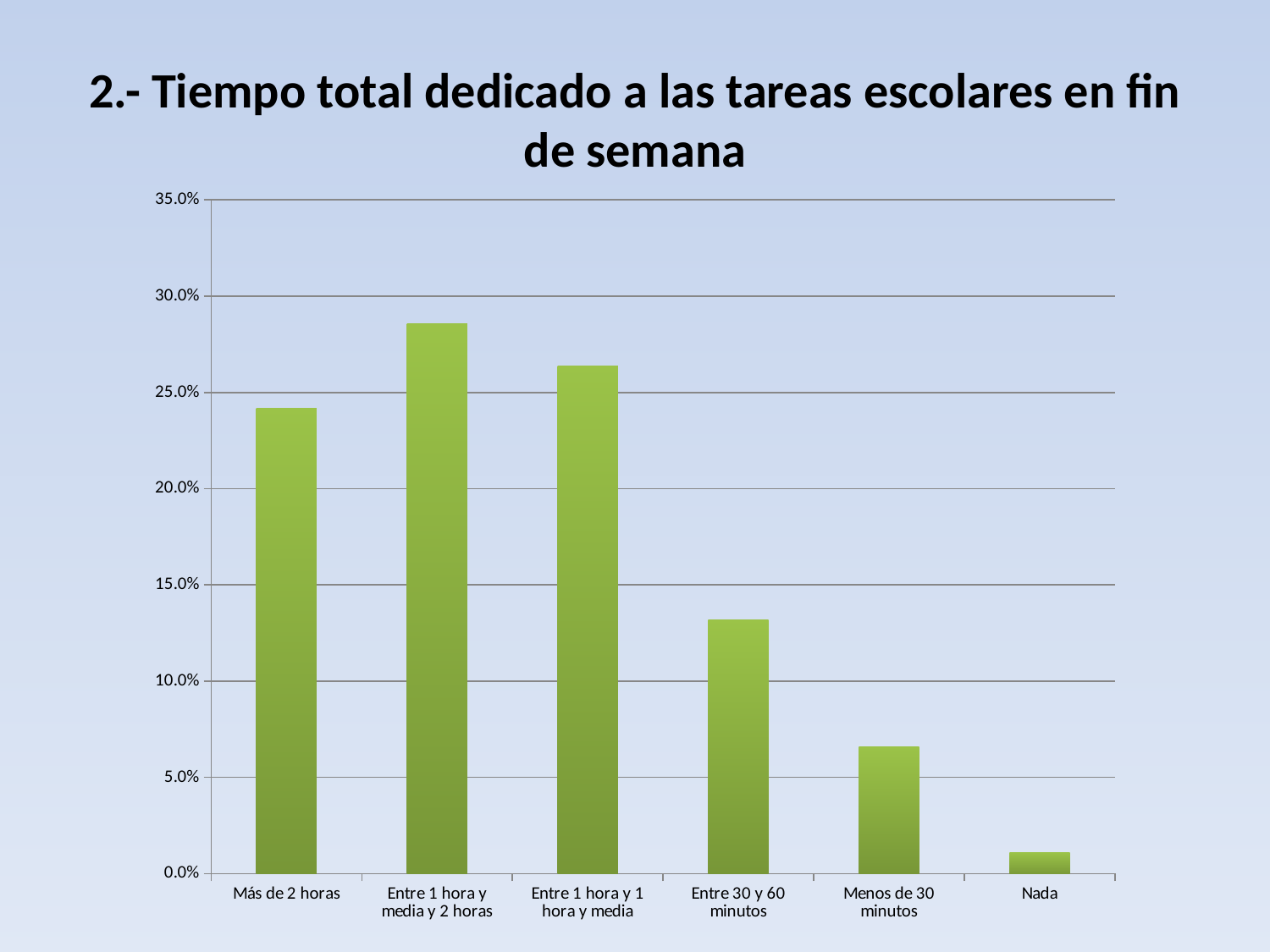
What kind of chart is shown on the slide? bar chart Is the value for Nada greater or less than 5.0%? less How many categories are shown on the x axis? 6 Which is larger, the value for Más de 2 horas or the value for Menos de 30 minutos? Más de 2 horas Which category has the highest value? Entre 1 hora y media y 2 horas Is the value for Entre 1 hora y media y 2 horas greater or less than 30.0%? less Is the value for Más de 2 horas greater or less than 20.0%? greater What is the title of the chart? 2.- Tiempo total dedicado a las tareas escolares en fin de semana Which is larger, the value for Entre 1 hora y 1 hora y media or the value for Entre 30 y 60 minutos? Entre 1 hora y 1 hora y media Which category has the lowest value? Nada